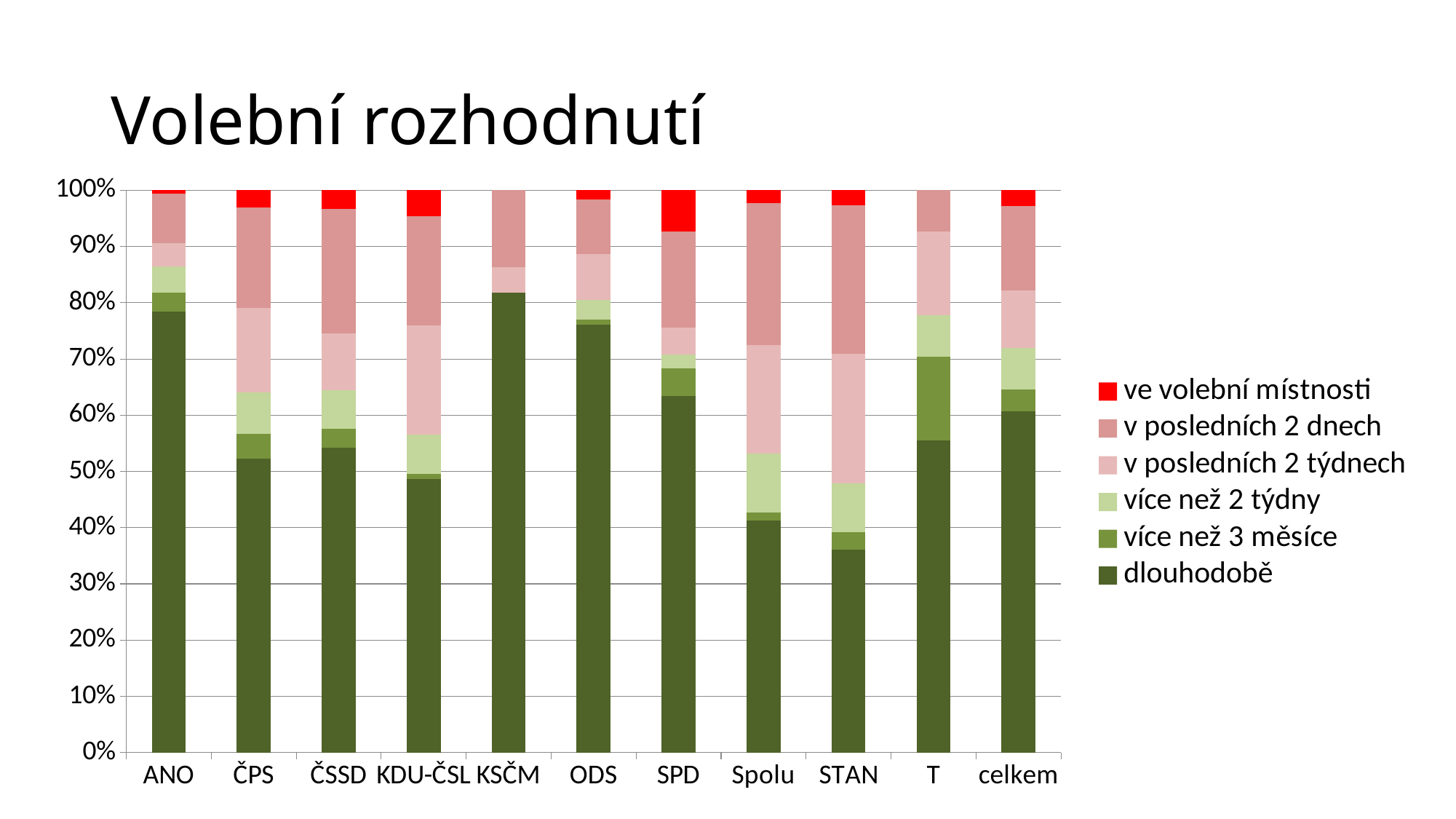
Which legend entry is shown in bright red? ve volební místnosti What is the total of the stacked bar for celkem? 100% Which category has the largest 'dlouhodobě' segment? KSČM Is the 'dlouhodobě' value for SPD greater or less than 60%? greater How many categories are shown along the x axis? 11 Is the 'dlouhodobě' value for ANO greater or less than 70%? greater Which has the larger 'dlouhodobě' segment, ANO or ČPS? ANO How many series does the legend list? 6 What is the title of the chart? Volební rozhodnutí What kind of chart is shown on the slide? stacked bar chart Is the 'dlouhodobě' value for STAN greater or less than 40%? less Which category has the smallest 'dlouhodobě' segment? STAN